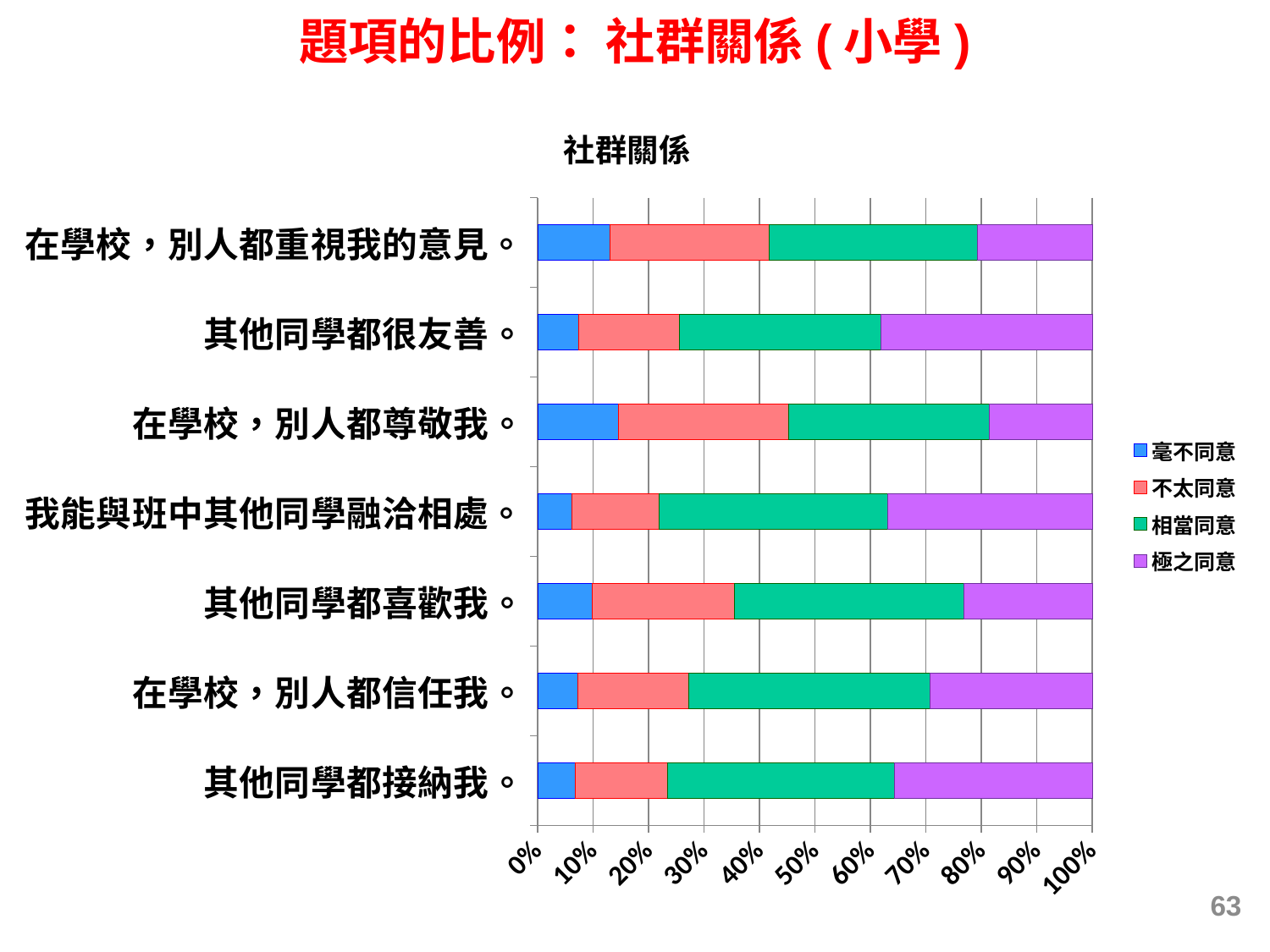
Which has the larger 極之同意 share: 其他同學都很友善 or 在學校，別人都尊敬我? 其他同學都很友善 Is the 極之同意 share for 其他同學都很友善 greater or less than 30%? greater Which legend entry is shown in purple? 極之同意 Is the 毫不同意 share for 我能與班中其他同學融洽相處 greater or less than 10%? less Is the 毫不同意 share for 在學校，別人都尊敬我 greater or less than 10%? greater Which has the larger 毫不同意 share: 在學校，別人都重視我的意見 or 其他同學都接納我? 在學校，別人都重視我的意見 What kind of chart is shown on the slide? Stacked bar chart How many series does the legend list? 4 What is the title of the chart? 社群關係 Which has the larger 不太同意 share: 在學校，別人都尊敬我 or 其他同學都很友善? 在學校，別人都尊敬我 How many statement categories are plotted on the chart? 7